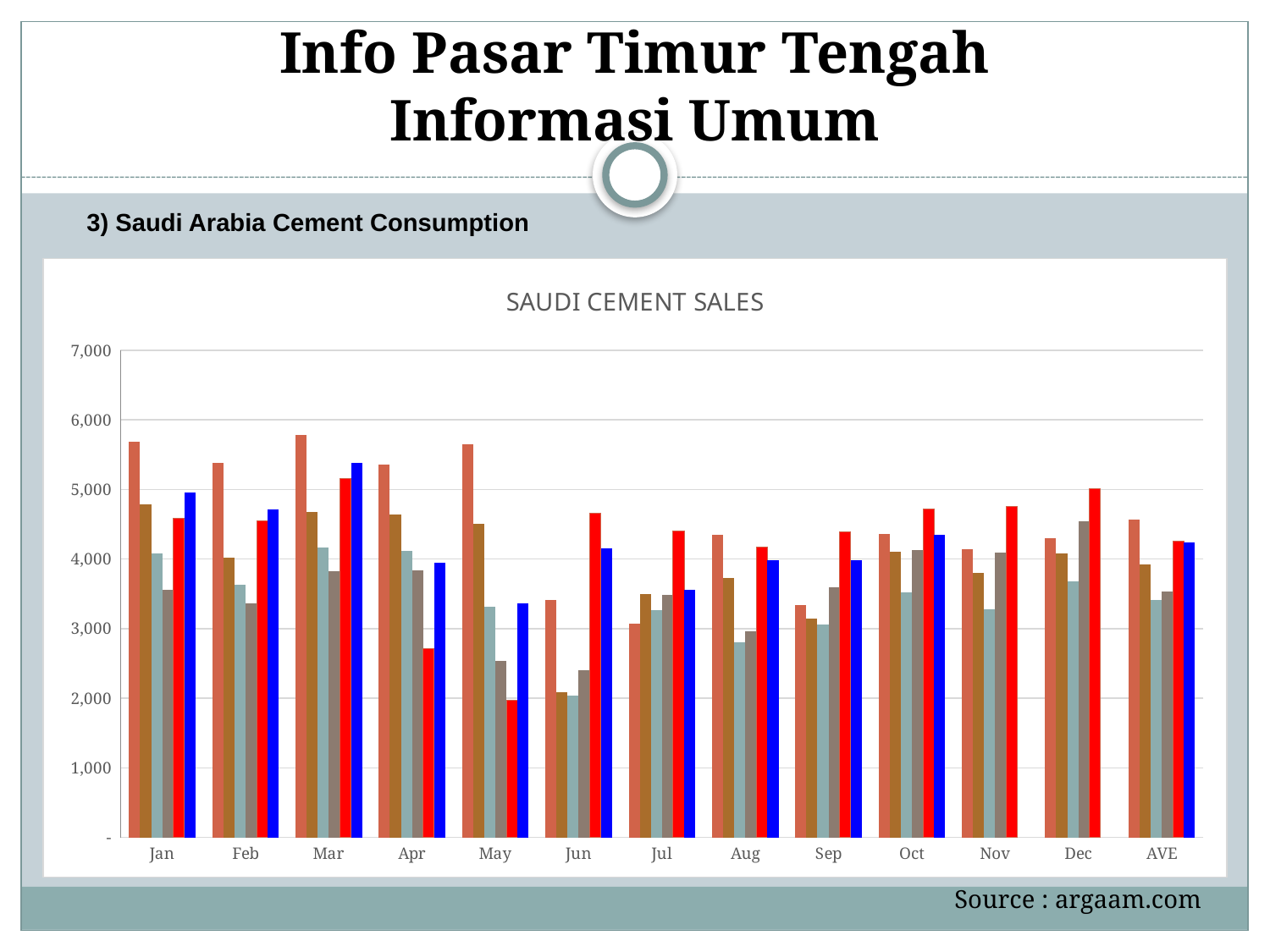
Which is larger, the red bar for Dec or the red bar for May? Dec What is the title of the chart? SAUDI CEMENT SALES How many categories are shown along the x axis of the chart? 13 Is the value of the blue bar for Jan greater or less than 4,000? greater In which month is the red bar the highest? Mar Is the value of the red bar for Apr greater or less than 3,000? less What is the highest value shown on the y axis of the chart? 7,000 Is the value of the red bar for Jun greater or less than 4,000? greater What kind of chart is shown on the slide? bar chart In which month is the red bar the lowest? May